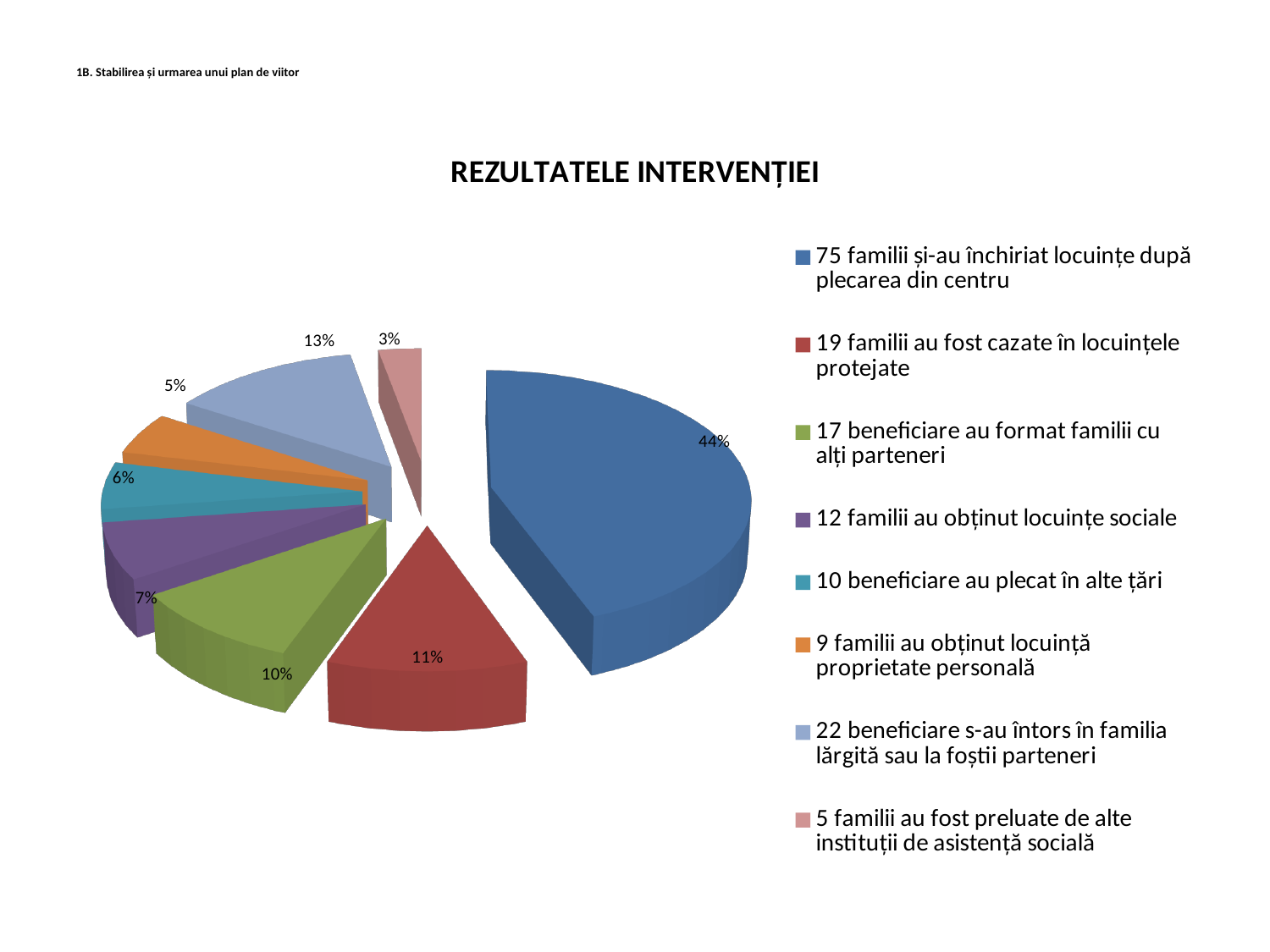
How many slices does the pie chart have? 8 Which category has the largest share of the pie? 75 familii și-au închiriat locuințe după plecarea din centru Which category has the smallest share of the pie? 5 familii au fost preluate de alte instituții de asistență socială What percentage share is shown for the slice '10 beneficiare au plecat în alte țări'? 6% What percentage share is shown for the slice '19 familii au fost cazate în locuințele protejate'? 11% What percentage share is shown for the slice '75 familii și-au închiriat locuințe după plecarea din centru'? 44% What kind of chart is shown on the slide? pie chart What is the title of the chart? REZULTATELE INTERVENȚIEI Which has the larger share: '12 familii au obținut locuințe sociale' or '9 familii au obținut locuință proprietate personală'? 12 familii au obținut locuințe sociale What is the difference in percentage points between the share for '75 familii și-au închiriat locuințe după plecarea din centru' and the share for '19 familii au fost cazate în locuințele protejate'? 33